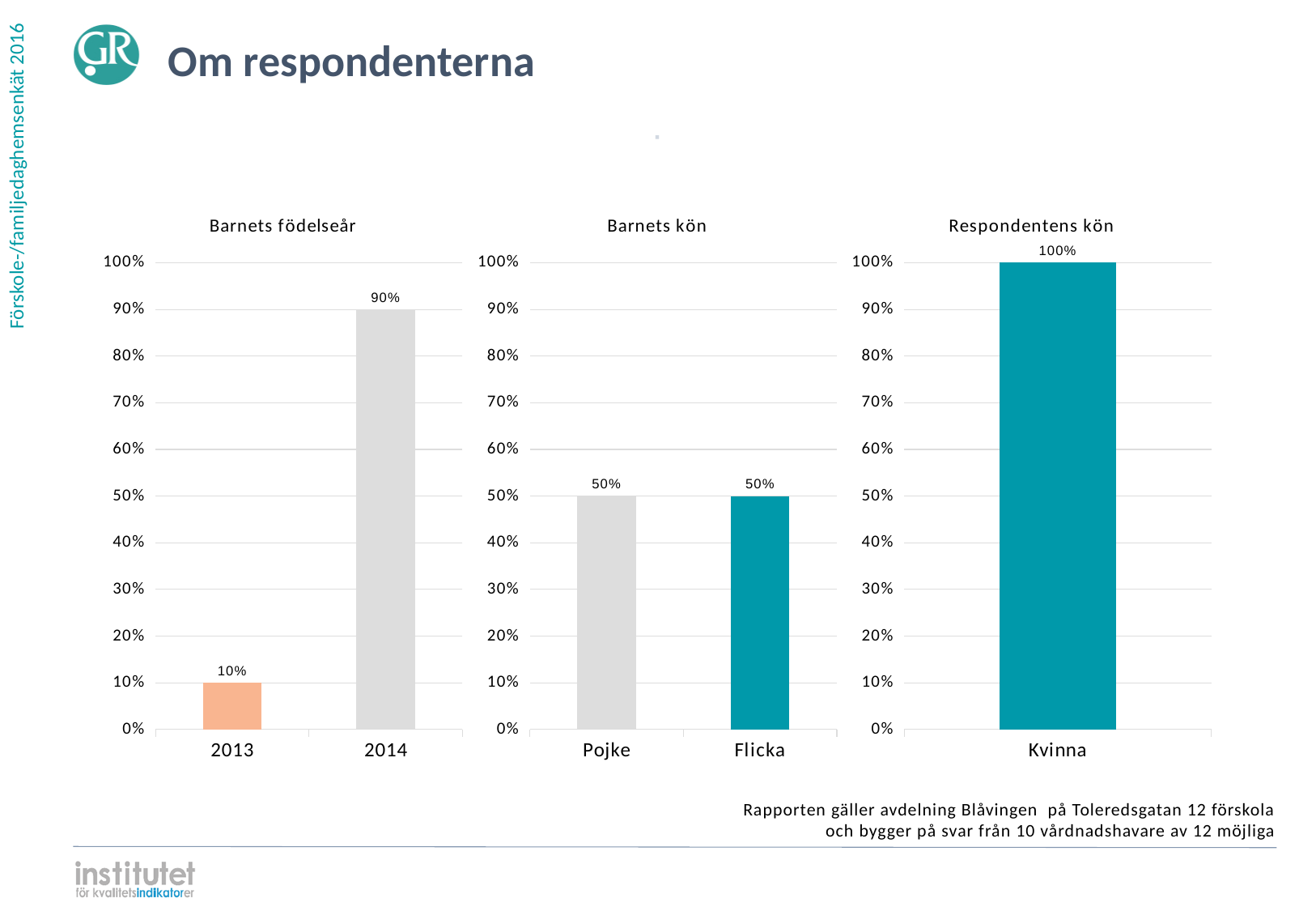
In the 'Respondentens kön' chart, what is the value for Kvinna? 100% In the 'Barnets födelseår' chart, what is the value for 2013? 10% In the 'Barnets födelseår' chart, what is the value for 2014? 90% What kind of chart is the 'Barnets födelseår' chart? bar chart In the 'Barnets födelseår' chart, which category has the highest value? 2014 In the 'Barnets kön' chart, what is the value for Flicka? 50% In the 'Barnets födelseår' chart, is the value for 2013 greater or less than 50%? less In the 'Barnets födelseår' chart, what is the difference between the values for 2014 and 2013? 80% How many charts are shown on the slide? 3 In the 'Barnets kön' chart, what is the value for Pojke? 50% In the 'Respondentens kön' chart, how many categories are shown? 1 In the 'Barnets kön' chart, how many categories are shown? 2